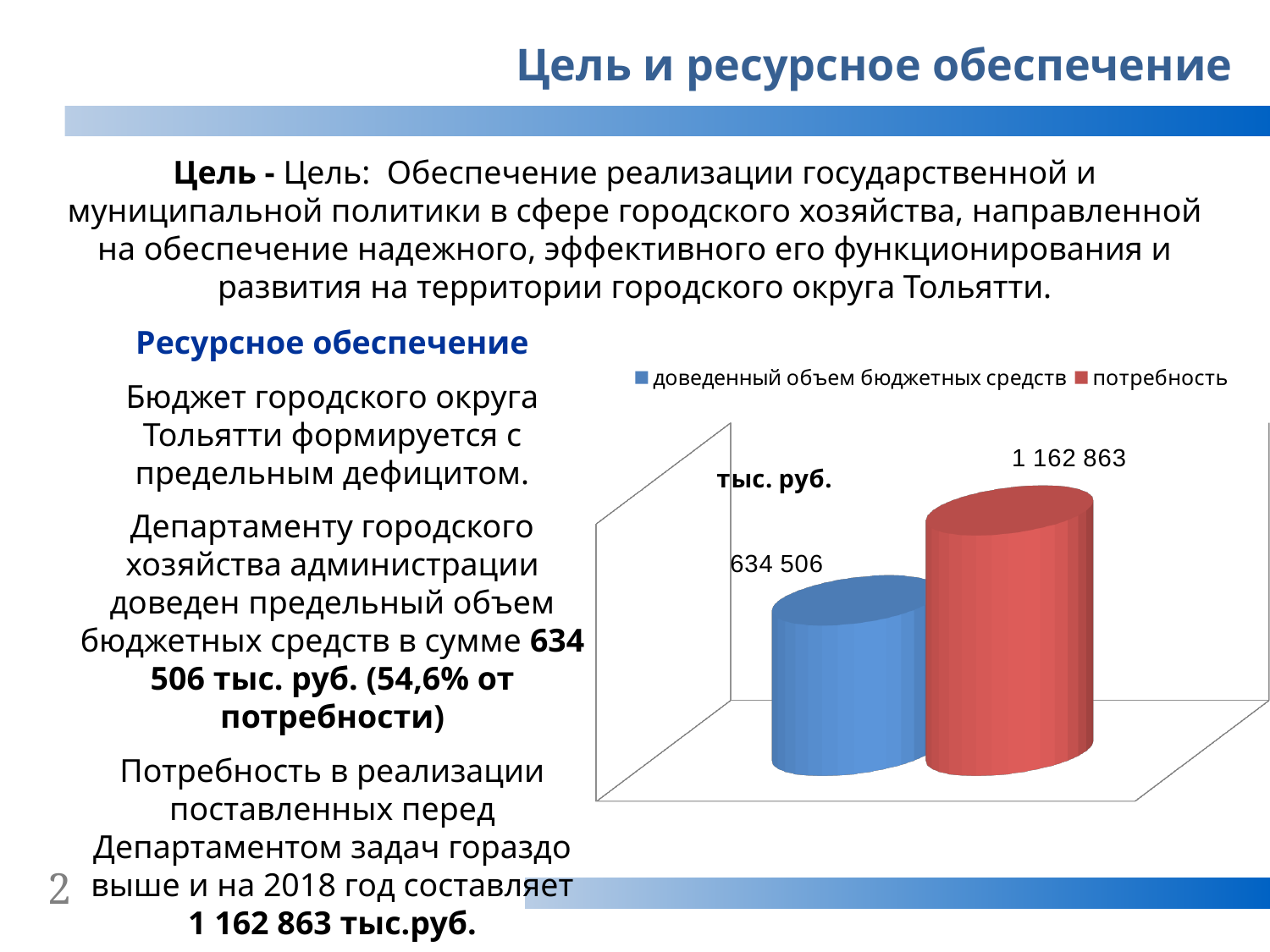
What unit label is shown on the chart? тыс. руб. Which series has the highest value on the chart? потребность How many bars are plotted on the chart? 2 How many series does the chart legend list? 2 Which series has the lowest value on the chart? доведенный объем бюджетных средств What is the value shown for the series "доведенный объем бюджетных средств"? 634 506 Which series has the higher value, "доведенный объем бюджетных средств" or "потребность"? потребность What is the difference between the value for "потребность" and the value for "доведенный объем бюджетных средств"? 528 357 What colour is the bar for "потребность"? red What is the value shown for the series "потребность"? 1 162 863 What kind of chart is shown on the slide? bar chart